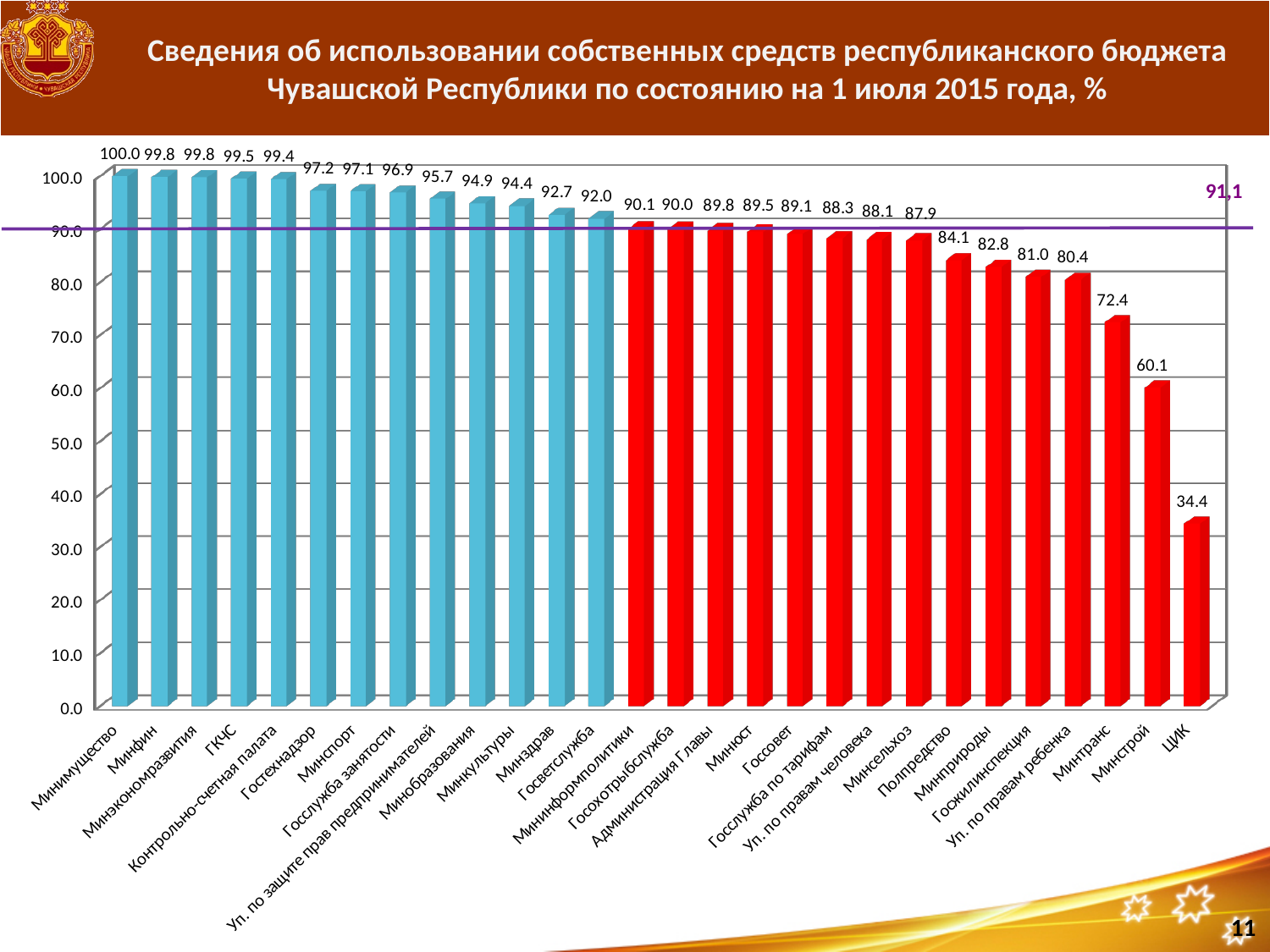
Which is larger, the value for Полпредство or the value for Минтранс? Полпредство Is the value for Уп. по правам ребенка greater or less than 90.0? less What is the difference between the values for Минтранс and ЦИК? 38.0 What is the value for Минсельхоз? 87.9 Which category has the lowest value? ЦИК What is the difference between the values for Минимущество and Минстрой? 39.9 What kind of chart is shown on the slide? bar chart What value is labelled on the horizontal line drawn across the chart? 91,1 Which category has the highest value? Минимущество What is the value for Госслужба занятости? 96.9 What is the value for Минстрой? 60.1 How many categories are shown on the chart? 28